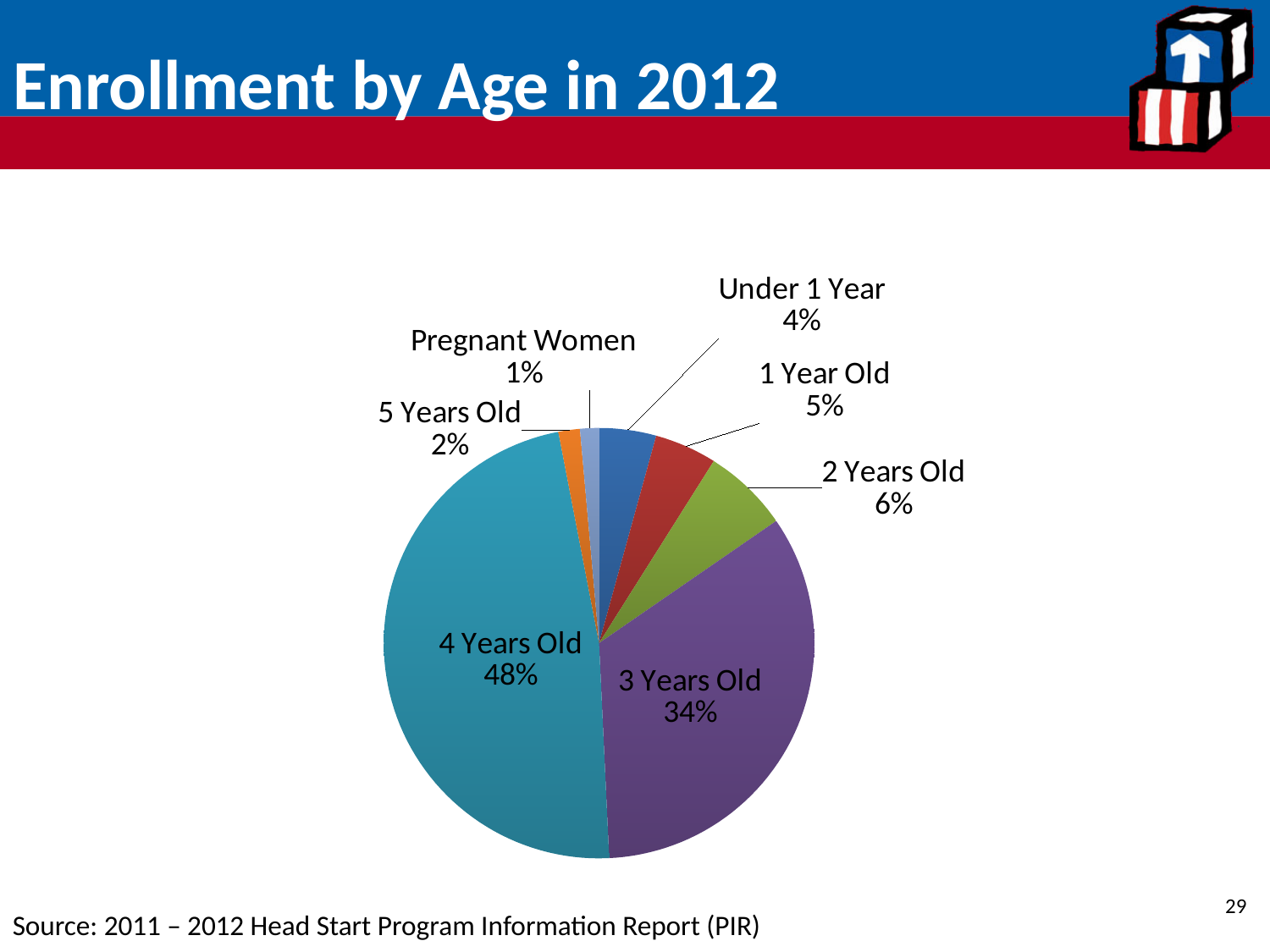
Which category has the largest share of enrollment? 4 Years Old What is the combined share of 3 Years Old and 4 Years Old? 82% What percentage of enrollment is 4 Years Old? 48% What is the title of the slide containing the chart? Enrollment by Age in 2012 How many categories are shown in the pie chart? 7 What type of chart is shown on the slide? pie chart What percentage of enrollment is 3 Years Old? 34% What is the difference in percentage points between 4 Years Old and 3 Years Old? 14 Which category has the smallest share of enrollment? Pregnant Women What percentage of enrollment is Under 1 Year? 4% Which is larger, the share for 2 Years Old or the share for 1 Year Old? 2 Years Old What percentage of enrollment is Pregnant Women? 1%